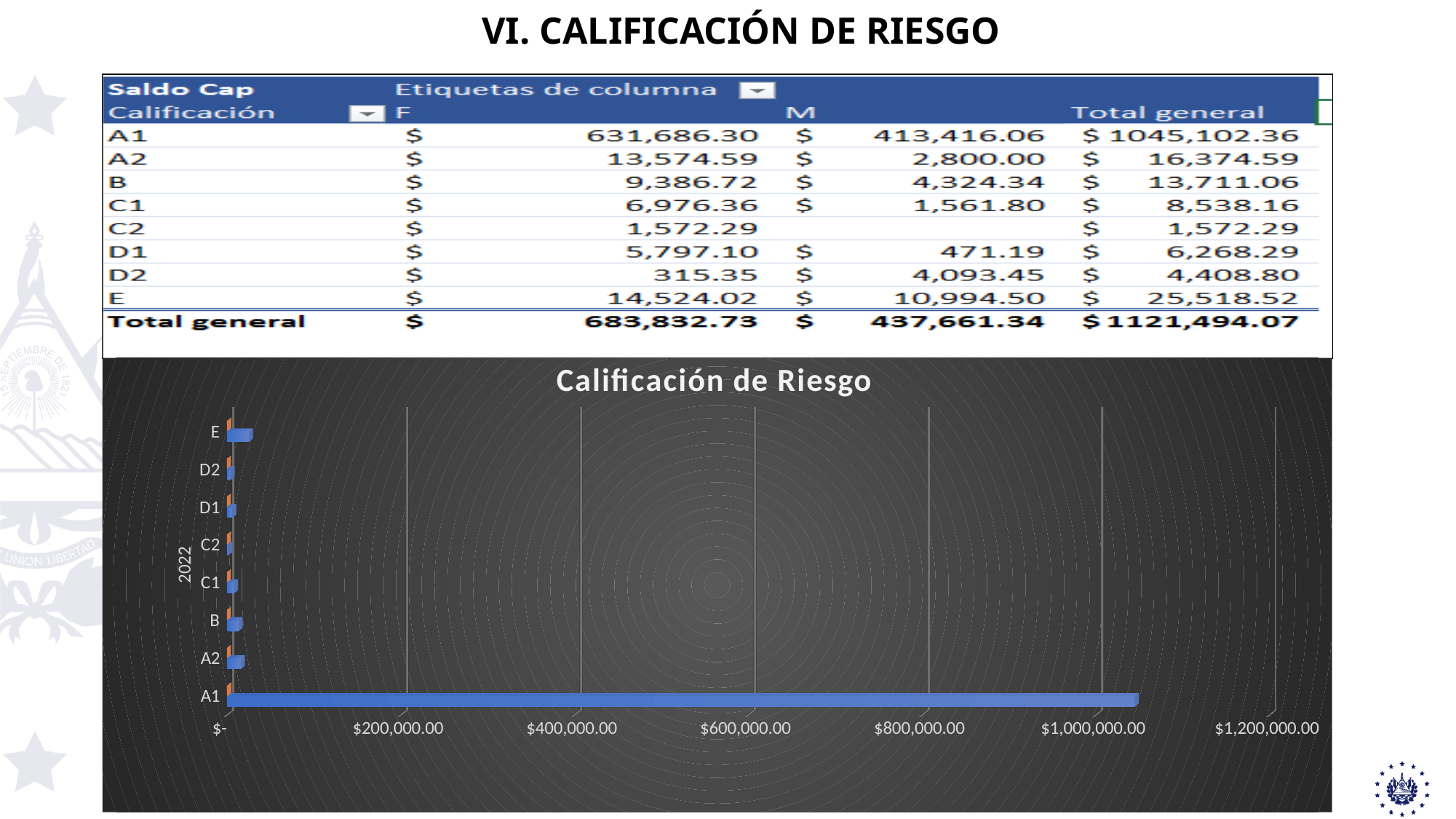
In the "Calificación de Riesgo" chart, which is larger, the value for A1 or the value for E? A1 In the "Calificación de Riesgo" chart, is the value for A2 greater or less than $200,000.00? less In the "Calificación de Riesgo" chart, which is larger, the value for B or the value for A1? A1 In the "Calificación de Riesgo" chart, is the value for E greater or less than $200,000.00? less In the "Calificación de Riesgo" chart, what is the highest tick value shown on the horizontal axis? $1,200,000.00 How many categories are plotted in the "Calificación de Riesgo" chart? 8 What type of chart is shown under the title "Calificación de Riesgo"? bar chart What label appears on the vertical axis of the "Calificación de Riesgo" chart? 2022 In the "Calificación de Riesgo" chart, is the value for A1 greater or less than $800,000.00? greater In the "Calificación de Riesgo" chart, which category has the highest value? A1 What is the title of the chart on the slide? Calificación de Riesgo